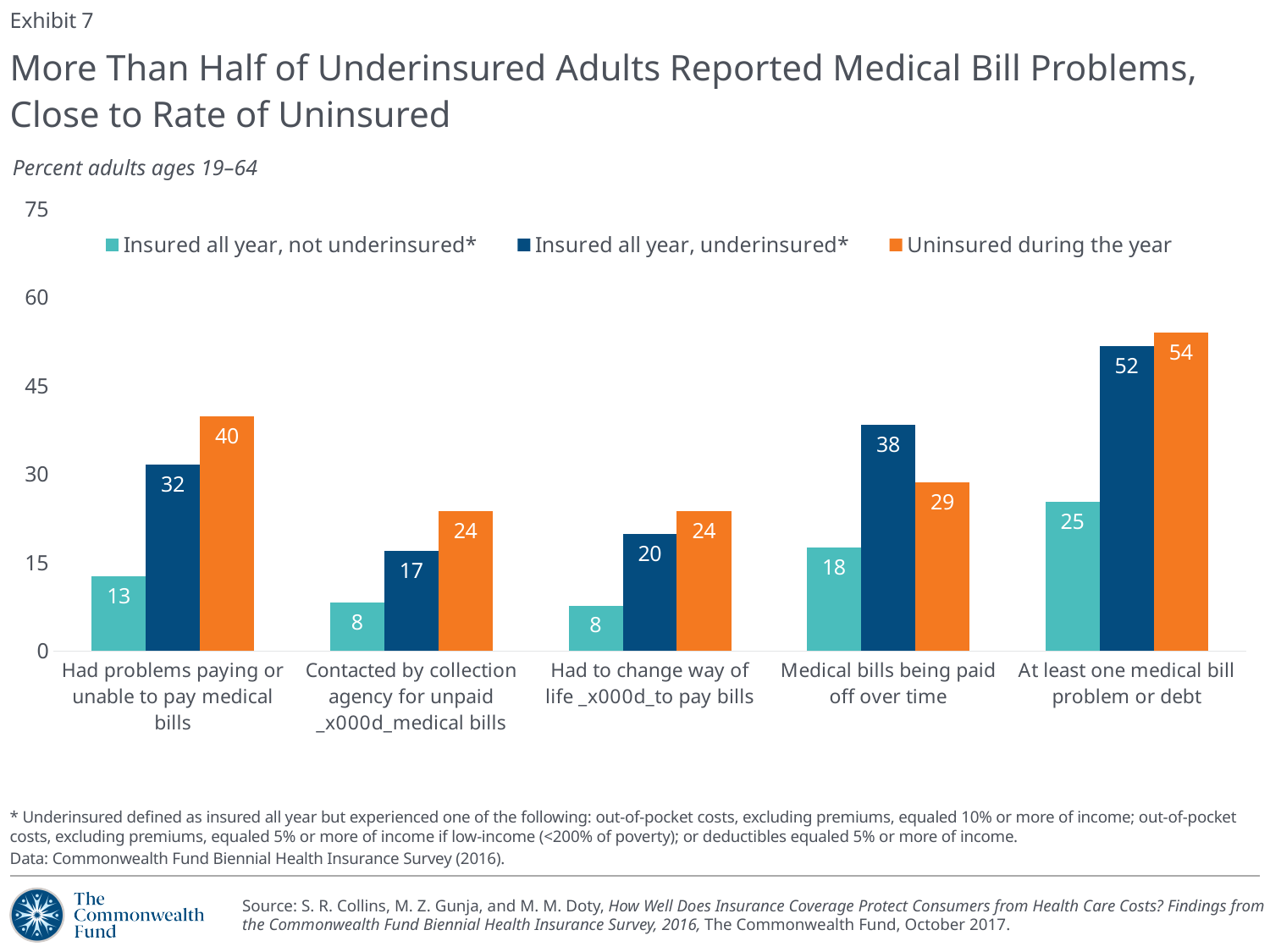
What kind of chart is shown on the slide? bar chart How many categories are shown on the x axis? 5 What colour represents the 'Uninsured during the year' series? orange How many series does the legend list? 3 What is the difference between the 'Uninsured during the year' and 'Insured all year, not underinsured*' values in the 'Had problems paying or unable to pay medical bills' category? 27 Which category has the highest value for the 'Insured all year, underinsured*' series? At least one medical bill problem or debt What is the value for 'Insured all year, not underinsured*' in the 'Medical bills being paid off over time' category? 18 What is the value for 'Uninsured during the year' in the 'At least one medical bill problem or debt' category? 54 In the 'Medical bills being paid off over time' category, which series has the larger value: 'Insured all year, underinsured*' or 'Uninsured during the year'? Insured all year, underinsured* Is the value for 'Insured all year, underinsured*' in the 'At least one medical bill problem or debt' category greater or less than 45? greater What is the value for 'Insured all year, underinsured*' in the 'Had problems paying or unable to pay medical bills' category? 32